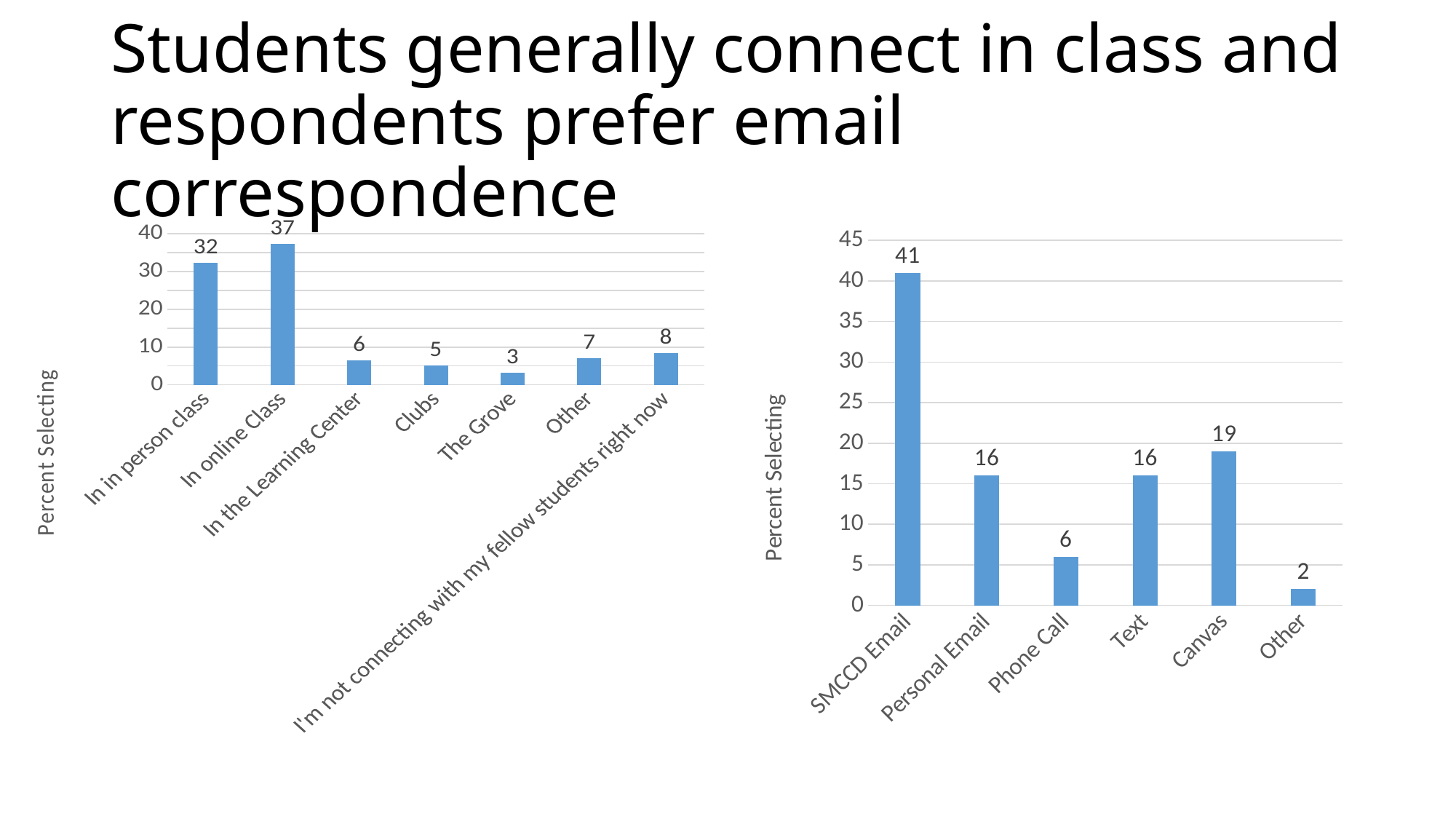
In the left chart, how many categories are shown on the x axis? 7 In the left chart, which category has the highest value? In online Class In the right chart, what is the difference between SMCCD Email and Personal Email? 25 What kind of chart is the right chart? bar chart In the left chart, what is the value for The Grove? 3 In the left chart, which category has the lowest value? The Grove In the right chart, which category has the highest value? SMCCD Email In the right chart, which category has the lowest value? Other In the left chart, what is the difference between In online Class and In in person class? 5 In the right chart, what is the value for Canvas? 19 In the right chart, which is larger, Canvas or Phone Call? Canvas In the left chart, what is the value for In online Class? 37